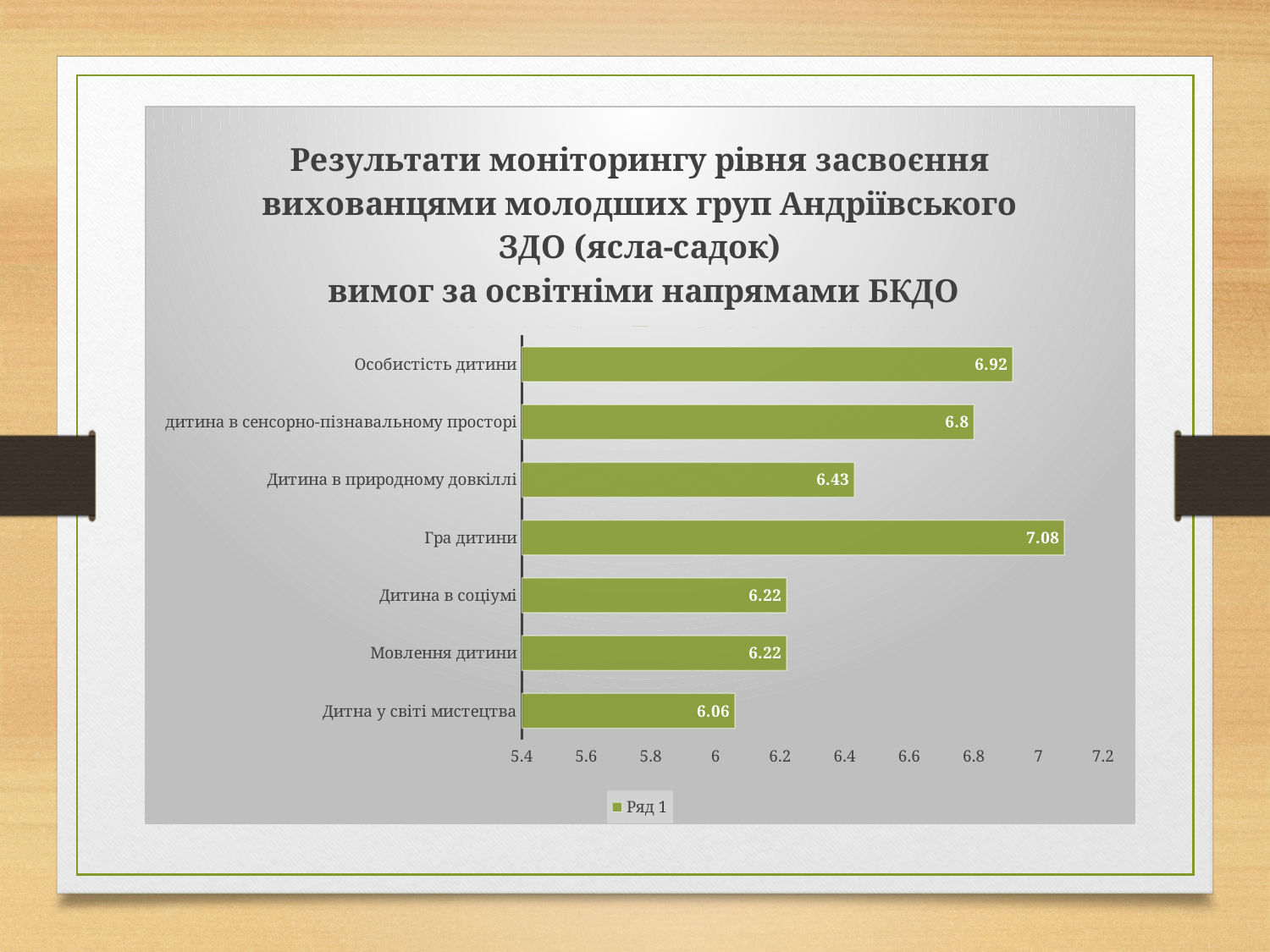
What is the value for Дитина в природному довкіллі? 6.43 Which is larger, the value for Особистість дитини or the value for Дитина в природному довкіллі? Особистість дитини Is the value for Дитина в соціумі greater or less than 6.4? less What is the difference between the values for Особистість дитини and дитина в сенсорно-пізнавальному просторі? 0.12 What kind of chart is shown on the slide? bar chart Which category has the highest value? Гра дитини How many categories are shown in the chart? 7 What is the name of the series shown in the legend? Ряд 1 Which category has the lowest value? Дитна у світі мистецтва What is the value for Дитна у світі мистецтва? 6.06 How many series does the legend list? 1 What is the value for Гра дитини? 7.08